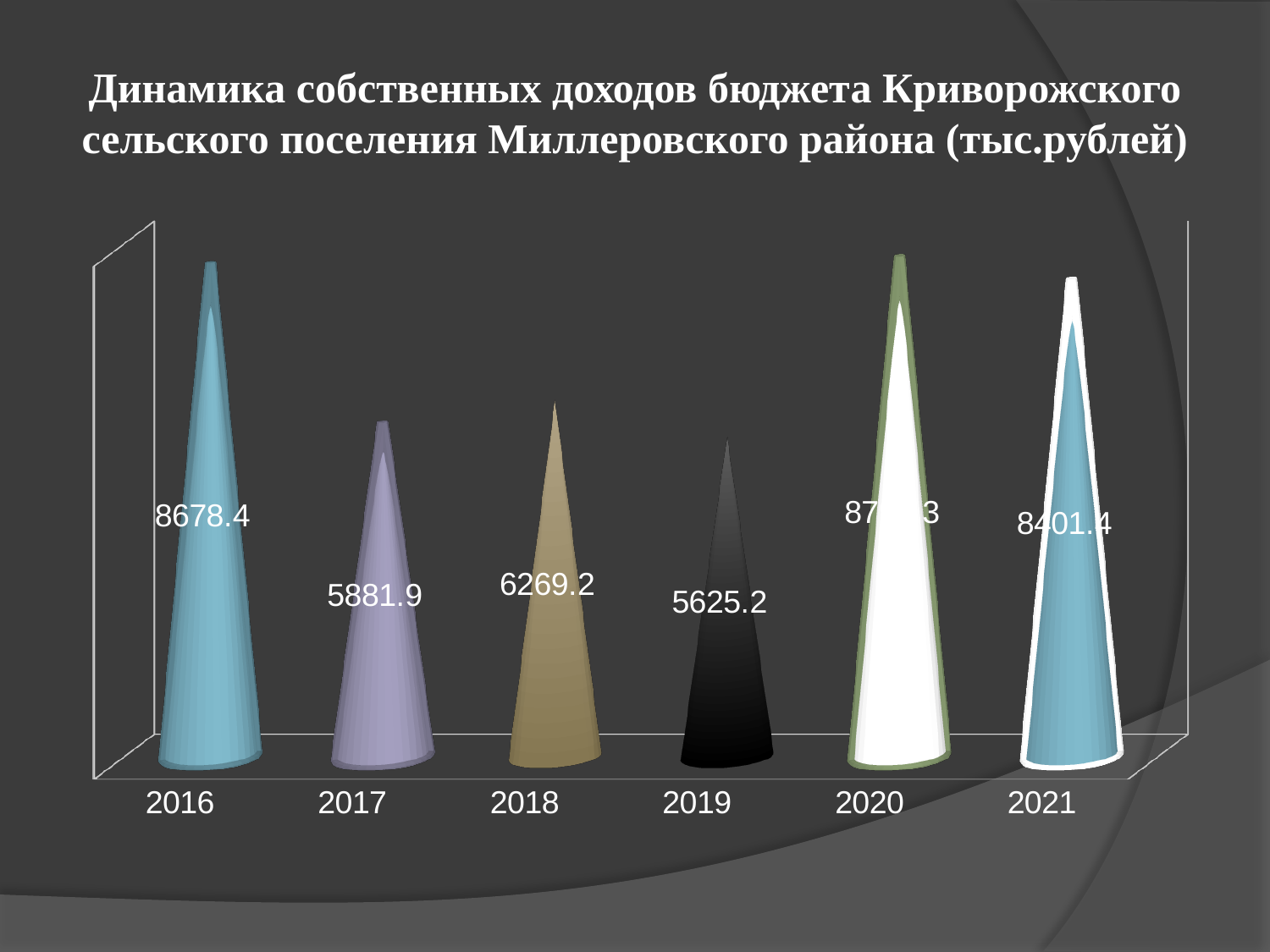
How many years are shown on the chart? 6 What is the value for 2018? 6269.2 What is the difference between the values for 2018 and 2017? 387.3 What is the difference between the values for 2016 and 2021? 277 Which year has the lowest value? 2019 Which is larger, the value for 2017 or the value for 2018? 2018 What is the value for 2021? 8401.4 Do the values rise or fall from 2016 to 2017? fall What is the value for 2017? 5881.9 What is the value for 2019? 5625.2 What is the value for 2016? 8678.4 What kind of chart is shown on the slide? bar chart